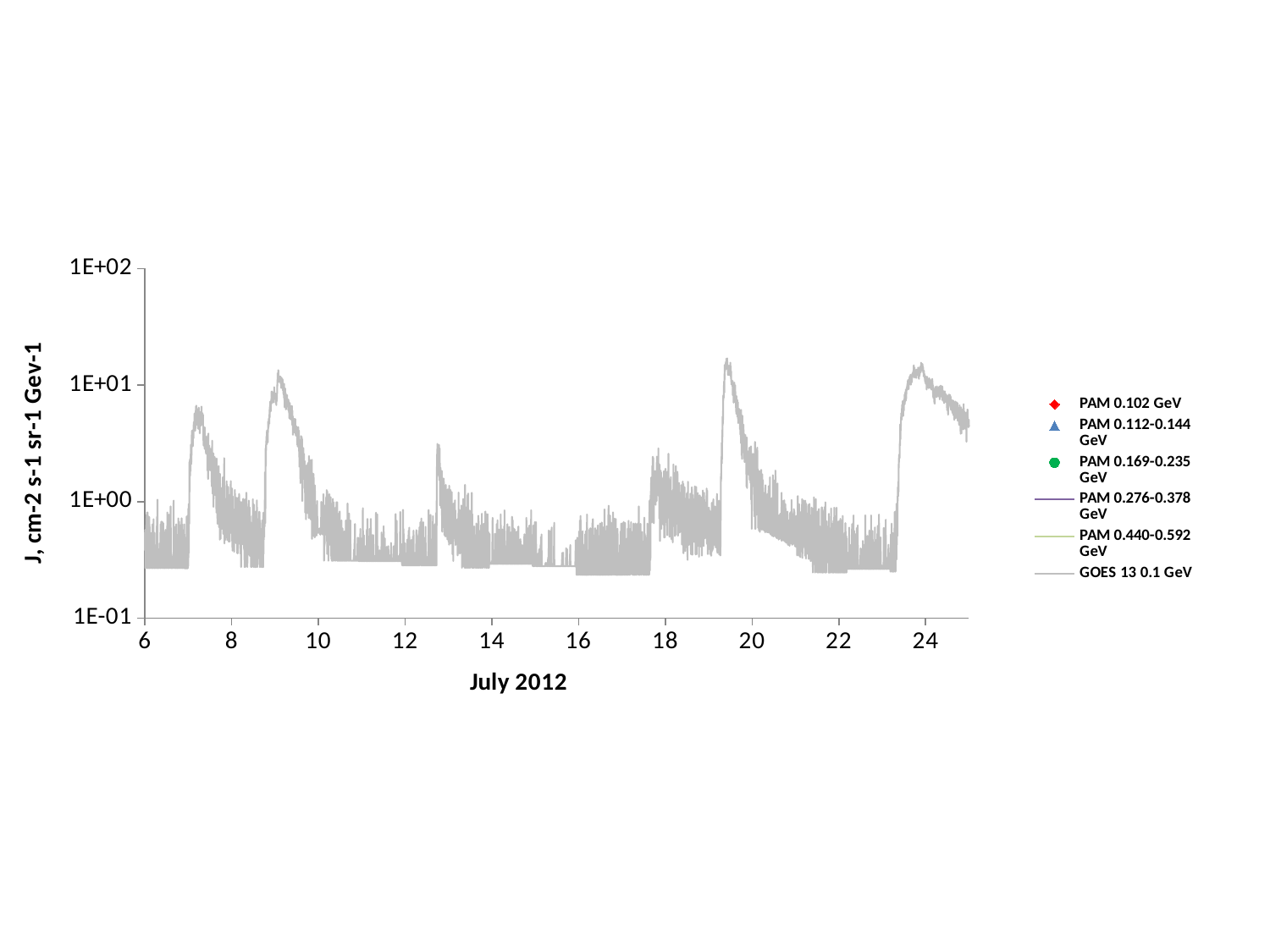
Which is larger for the GOES 13 0.1 GeV series: the peak near July 9 or the peak near July 7? the peak near July 9 Which legend entry is drawn as a grey line? GOES 13 0.1 GeV How many series does the legend list? 6 What is the title of the x axis? July 2012 Is the peak value of the GOES 13 0.1 GeV series near July 7 greater or less than 1E+01? less Is the value of the GOES 13 0.1 GeV series around July 15 greater or less than 1E+00? less Is the peak value of the GOES 13 0.1 GeV series near July 24 greater or less than 1E+01? greater Does the GOES 13 0.1 GeV series rise or fall between July 19.5 and July 21? fall Which is larger for the GOES 13 0.1 GeV series: the peak near July 19 or the peak near July 13? the peak near July 19 What kind of chart is shown on the slide? line chart